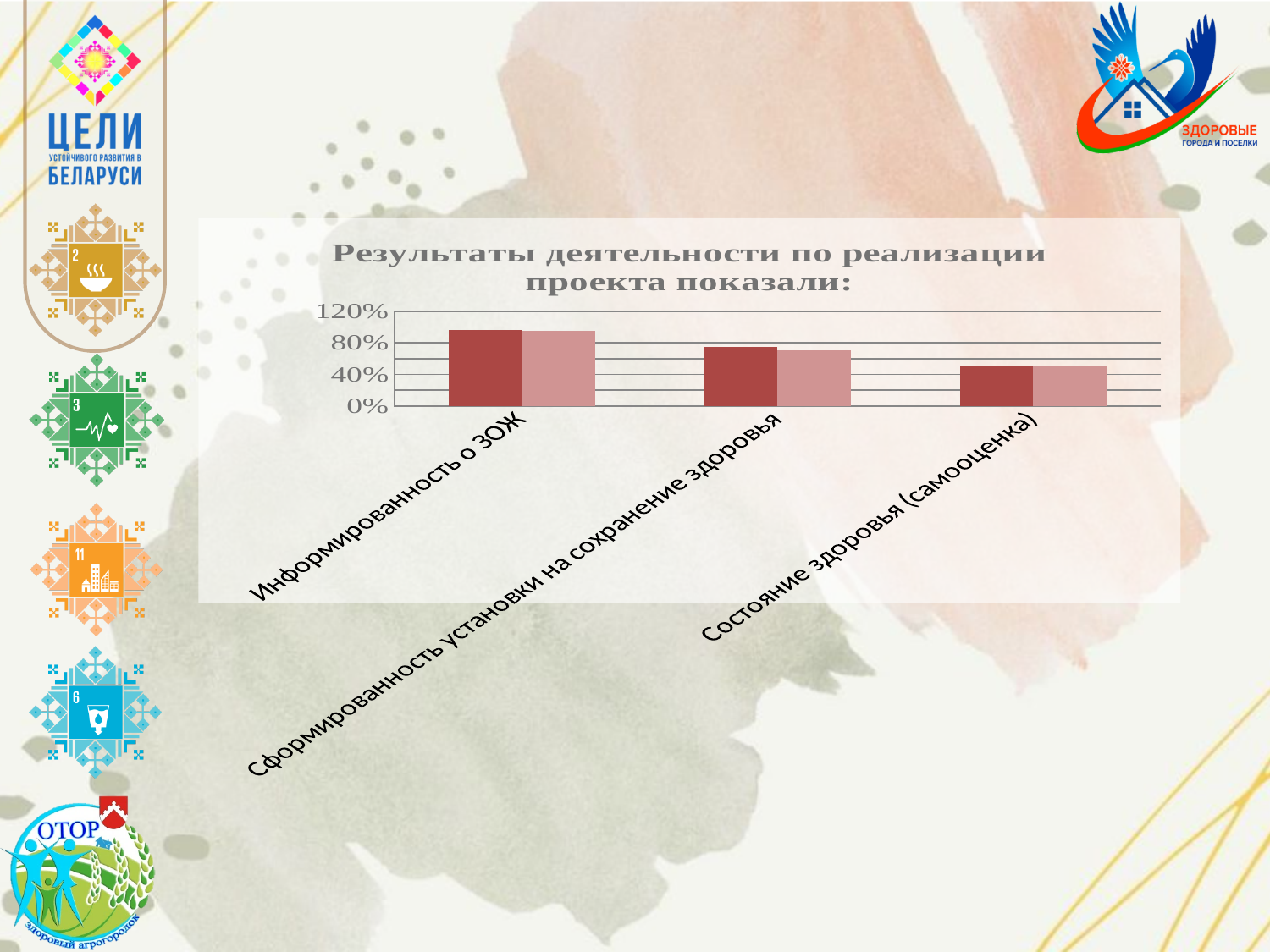
Which is larger: the dark red bar for Информированность о ЗОЖ or the dark red bar for Состояние здоровья (самооценка)? Информированность о ЗОЖ How many bars are plotted for each category in the chart? 2 How many categories are shown on the x axis of the chart? 3 Which category has the highest bars in the chart? Информированность о ЗОЖ Do the bar values rise or fall moving from left to right along the x axis? fall What is the title of the chart? Результаты деятельности по реализации проекта показали: What kind of chart is shown on the slide? bar chart Is the value of the dark red bar for Состояние здоровья (самооценка) greater or less than 80%? less Is the value of the dark red bar for Сформированность установки на сохранение здоровья greater or less than 40%? greater Is the value of the dark red bar for Информированность о ЗОЖ greater or less than 80%? greater Which category has the lowest bars in the chart? Состояние здоровья (самооценка)